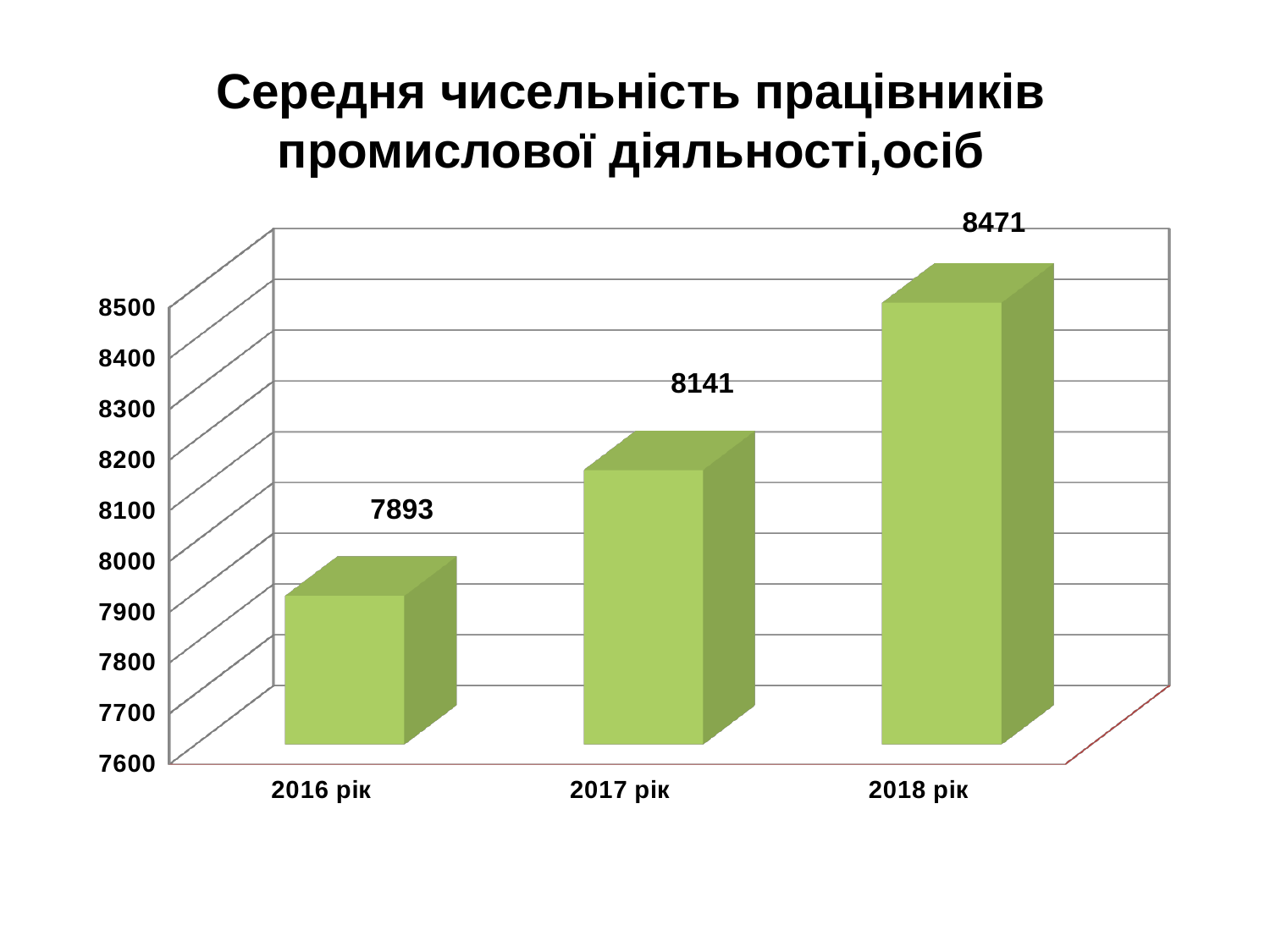
What is the value for 2018 рік? 8471 What is the value for 2017 рік? 8141 What kind of chart is shown on the slide? bar chart What is the difference between the values for 2017 рік and 2016 рік? 248 Is the value for 2016 рік greater or less than 8000? less Which is larger, the value for 2016 рік or 2017 рік? 2017 рік What is the difference between the values for 2018 рік and 2017 рік? 330 Do the values rise or fall from 2016 рік to 2018 рік? rise Which year has the highest value? 2018 рік What is the value for 2016 рік? 7893 How many years are shown on the chart? 3 Which year has the lowest value? 2016 рік